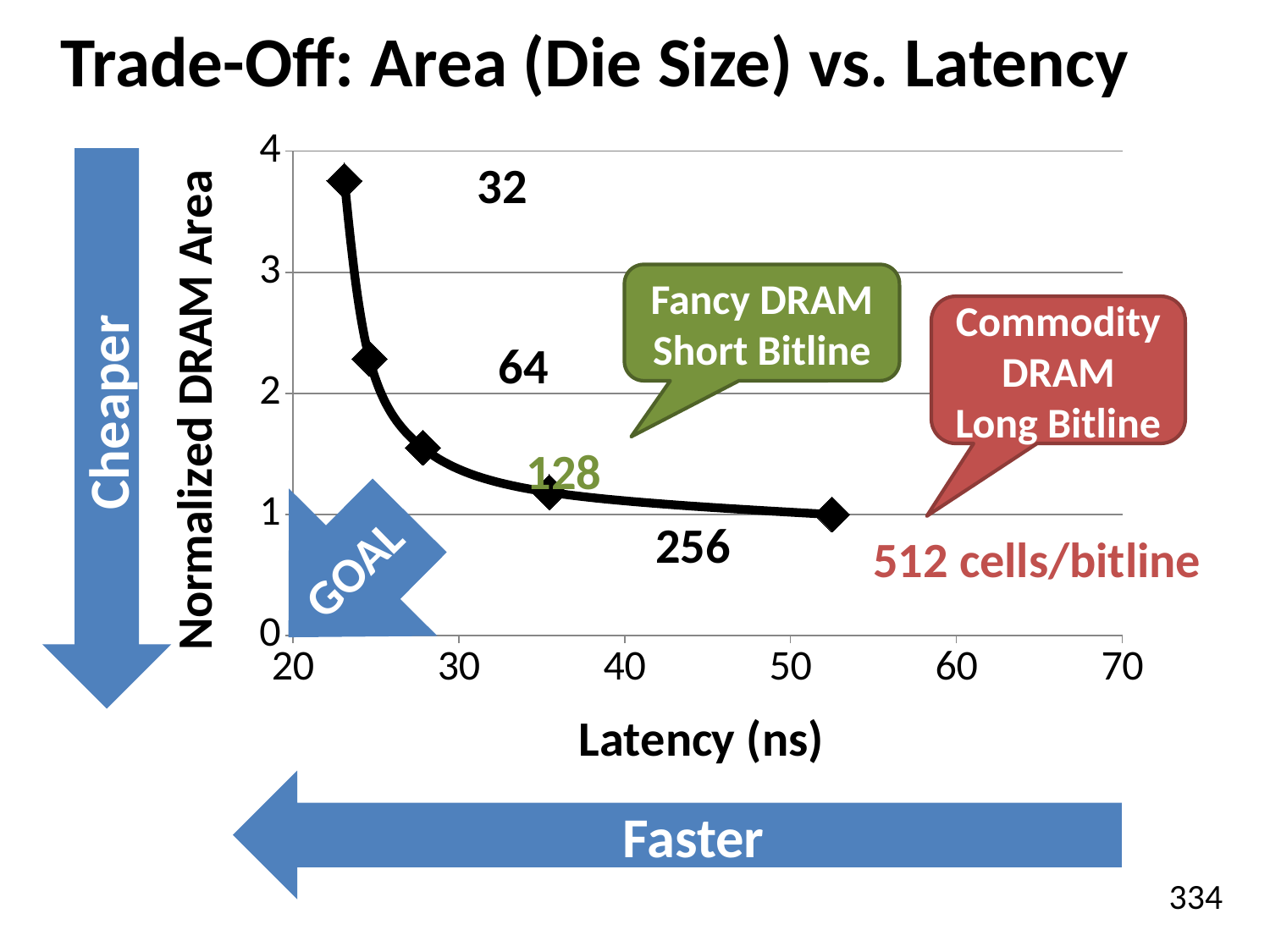
Is the normalized DRAM area for the 64 cells/bitline point greater or less than 2? greater Which labeled point has the highest latency? 512 cells/bitline Which labeled point has the highest normalized DRAM area? 32 Is the normalized DRAM area for the 32 cells/bitline point greater or less than 3? greater How many data points are plotted on the chart? 5 Which has a larger normalized DRAM area, the 64 point or the 128 point? 64 What is the title of the x axis? Latency (ns) What kind of chart is shown on the slide? line chart What is the title of the y axis? Normalized DRAM Area Is the latency for the 512 cells/bitline point greater or less than 50 ns? greater As latency increases along the x axis, does the normalized DRAM area rise or fall? fall